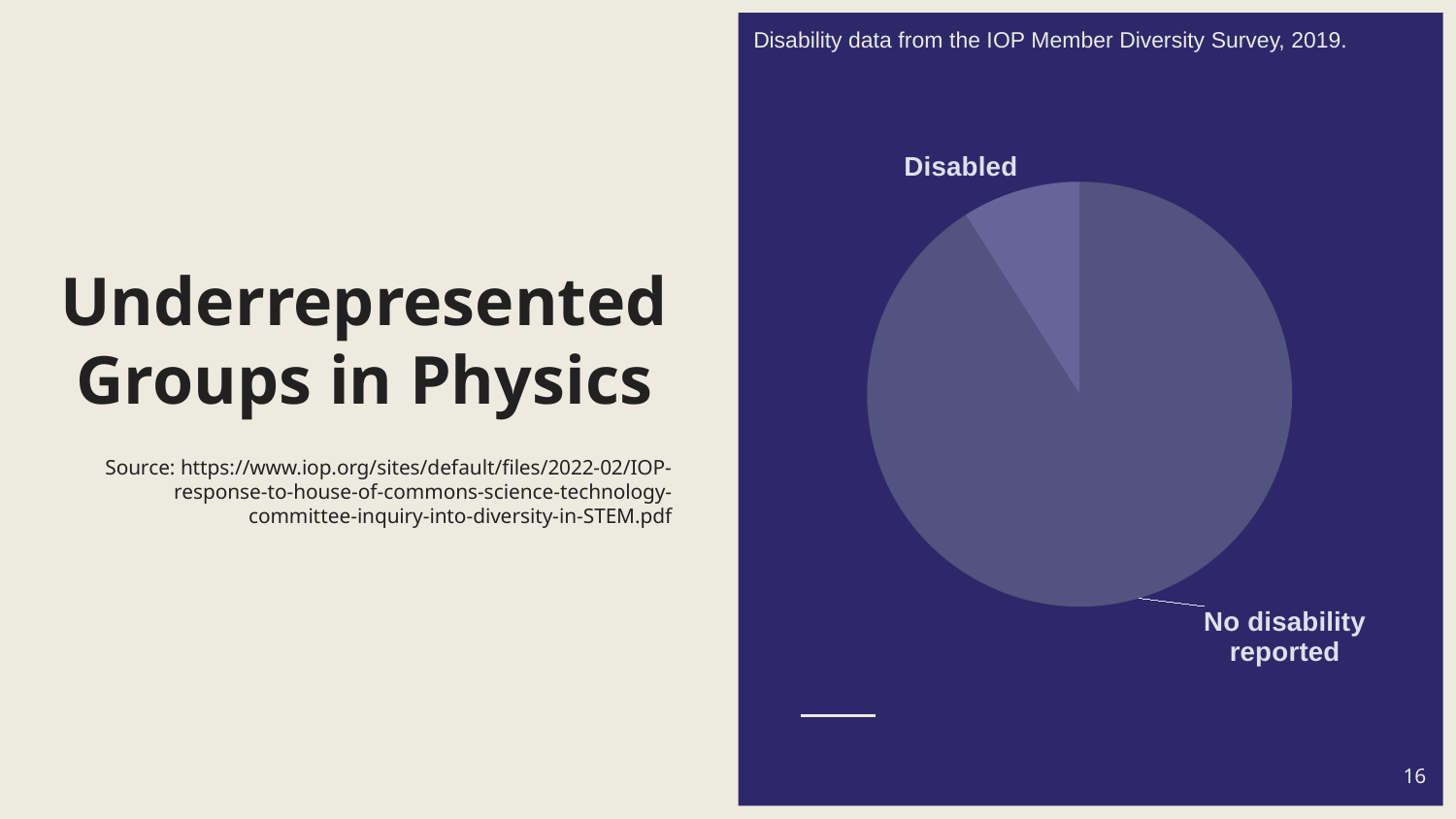
What is the title of the chart? Disability data from the IOP Member Diversity Survey, 2019. Which category has the smallest slice of the pie chart? Disabled How many slices does the pie chart have? 2 What are the two categories labelled on the pie chart? Disabled and No disability reported Which slice is larger, Disabled or No disability reported? No disability reported What kind of chart is shown on the slide? Pie chart Which category has the largest slice of the pie chart? No disability reported